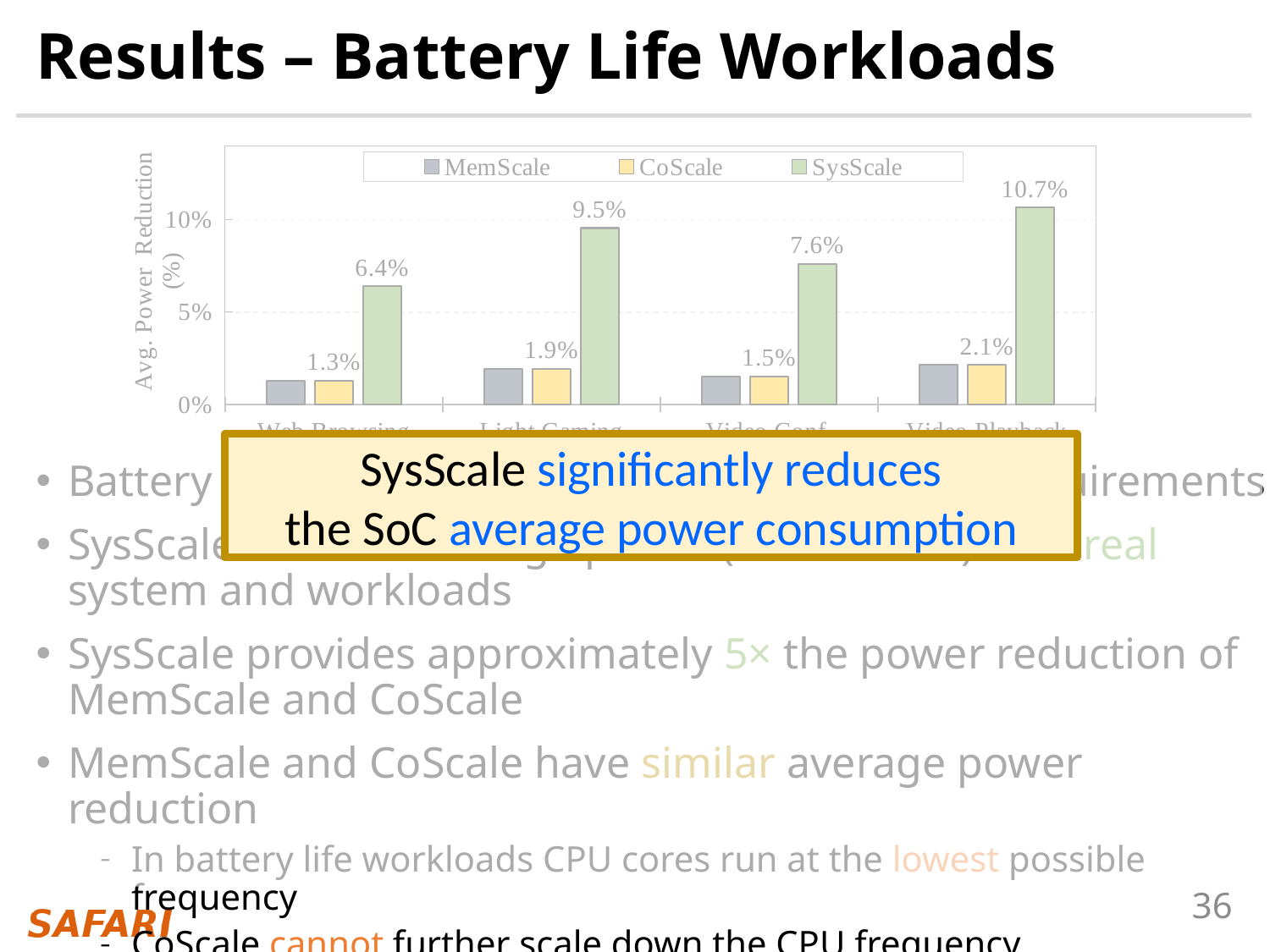
Which workload group has the highest SysScale value? the fourth (rightmost) group Is the MemScale value for the first workload group greater or less than 5%? less What kind of chart is shown on the slide? bar chart What is the difference between the SysScale values of the fourth and second workload groups? 1.2% How many series does the chart legend list? 3 Which workload group has the lowest SysScale value? the first (leftmost) group Is the SysScale value larger in the second workload group or the third workload group? the second group What is the CoScale value for the fourth (rightmost) workload group? 2.1% What is the title of the y axis? Avg. Power Reduction (%) What is the SysScale value for the first (leftmost) workload group? 6.4% What is the SysScale value for the fourth (rightmost) workload group? 10.7% How many workload groups (categories) are plotted along the x axis? 4